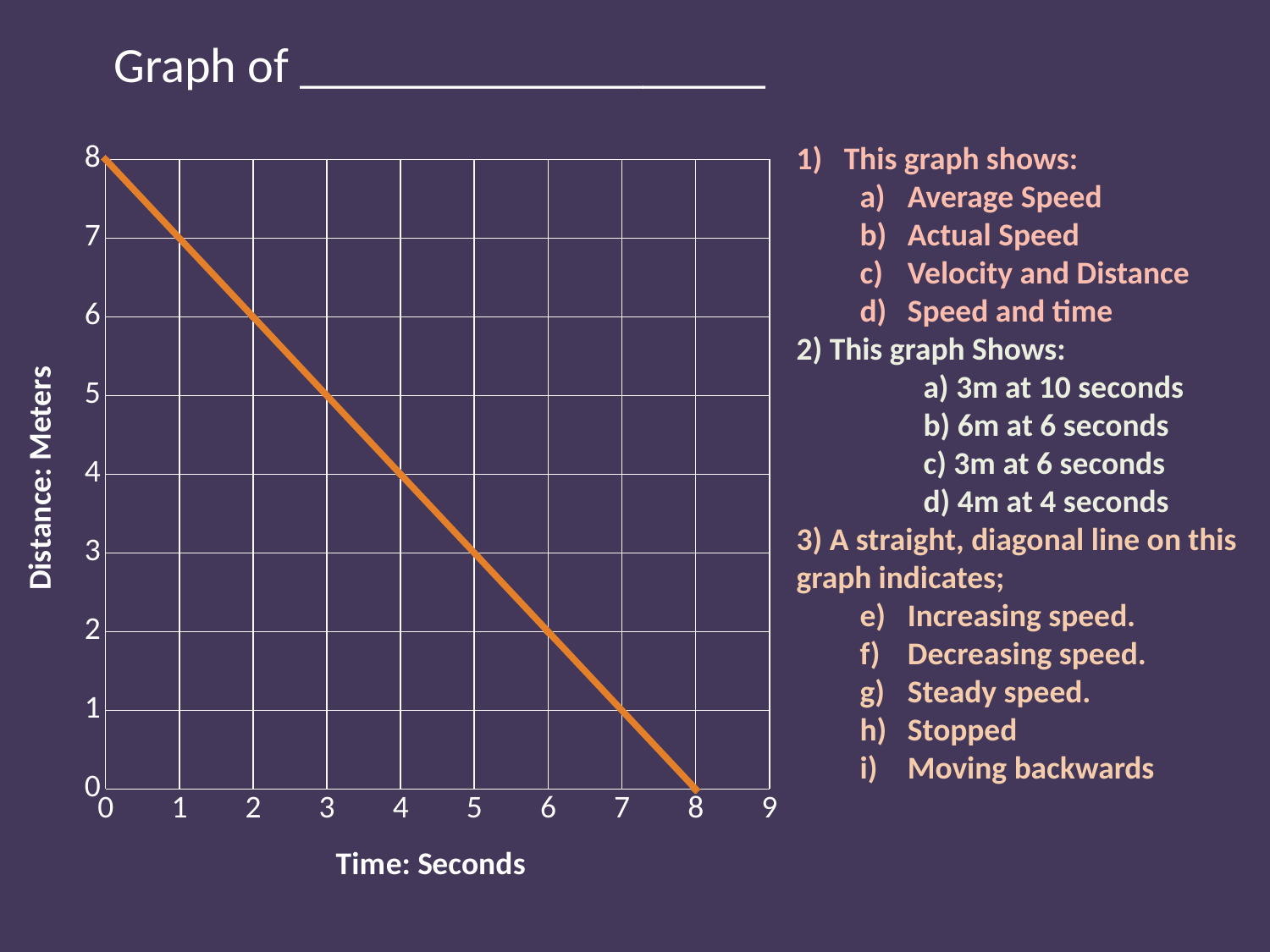
What is the difference between the distance at 1 second and the distance at 5 seconds? 4 What is the distance at 6 seconds? 2 What is the distance at 4 seconds? 4 Does the distance rise or fall as time increases along the x axis? fall Is the distance at 3 seconds greater or less than 4? greater What is the label of the x axis? Time: Seconds At what time does the line reach its lowest distance value? 8 What is the distance at 8 seconds? 0 What kind of chart is shown on the slide? line chart Which is larger, the distance at 2 seconds or the distance at 7 seconds? 2 seconds What is the label of the y axis? Distance: Meters What is the distance at 0 seconds? 8